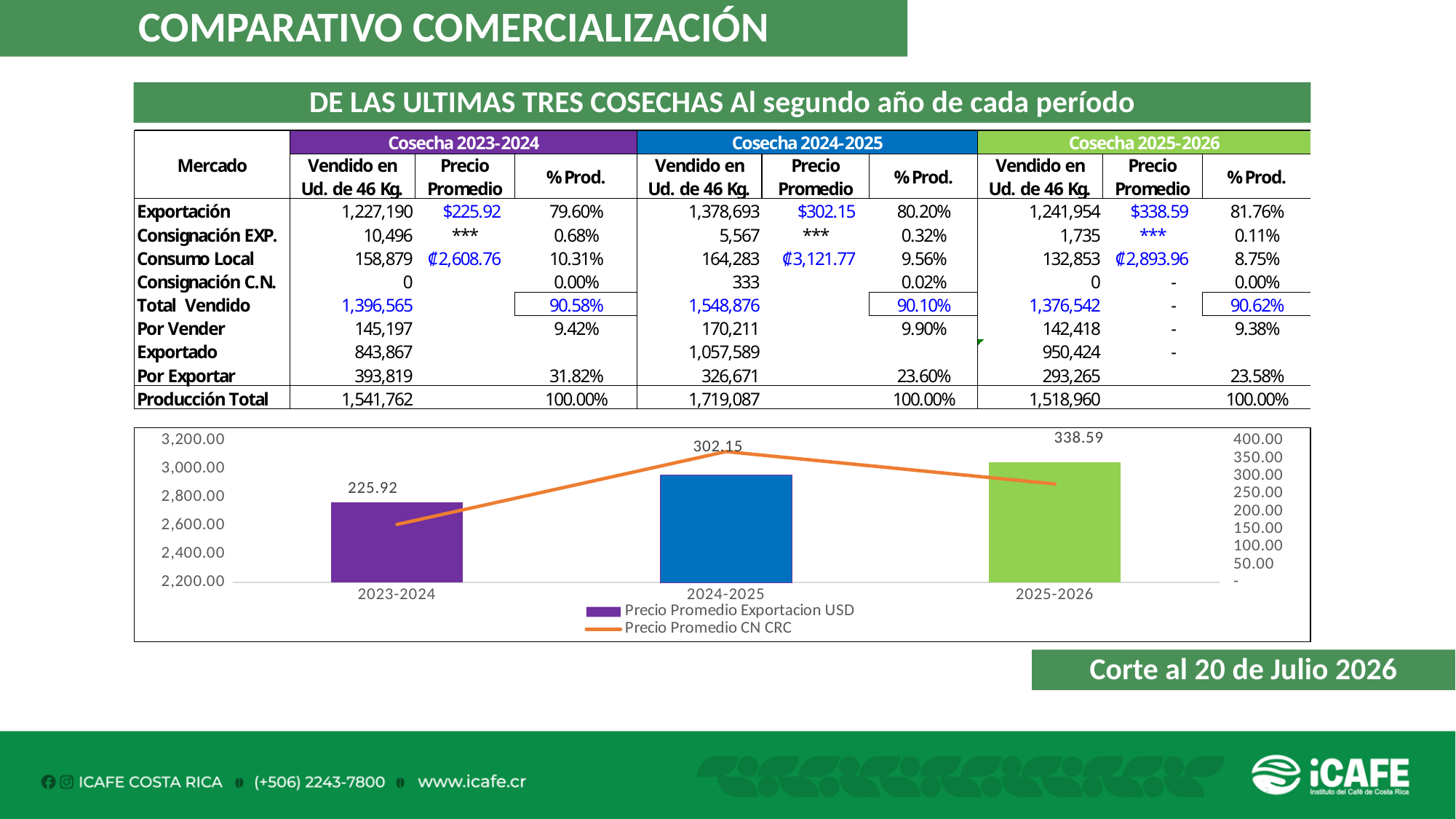
What is the difference between the Precio Promedio Exportacion USD values for 2025-2026 and 2023-2024? 112.67 Is the Precio Promedio CN CRC line value for 2024-2025 greater or less than 3,000.00? greater What is the Precio Promedio Exportacion USD value shown for 2023-2024? 225.92 Is the Precio Promedio CN CRC line value for 2023-2024 greater or less than 2,800.00? less Which harvest period has the lowest Precio Promedio Exportacion USD bar? 2023-2024 What is the difference between the Precio Promedio Exportacion USD values for 2025-2026 and 2024-2025? 36.44 Is the Precio Promedio CN CRC line value for 2025-2026 greater or less than 3,000.00? less What is the Precio Promedio Exportacion USD value shown for 2024-2025? 302.15 Do the Precio Promedio Exportacion USD bars rise or fall from 2023-2024 to 2025-2026? rise How many harvest periods are shown on the x axis of the chart? 3 Which harvest period has the highest Precio Promedio Exportacion USD bar? 2025-2026 How many series does the chart legend list? 2